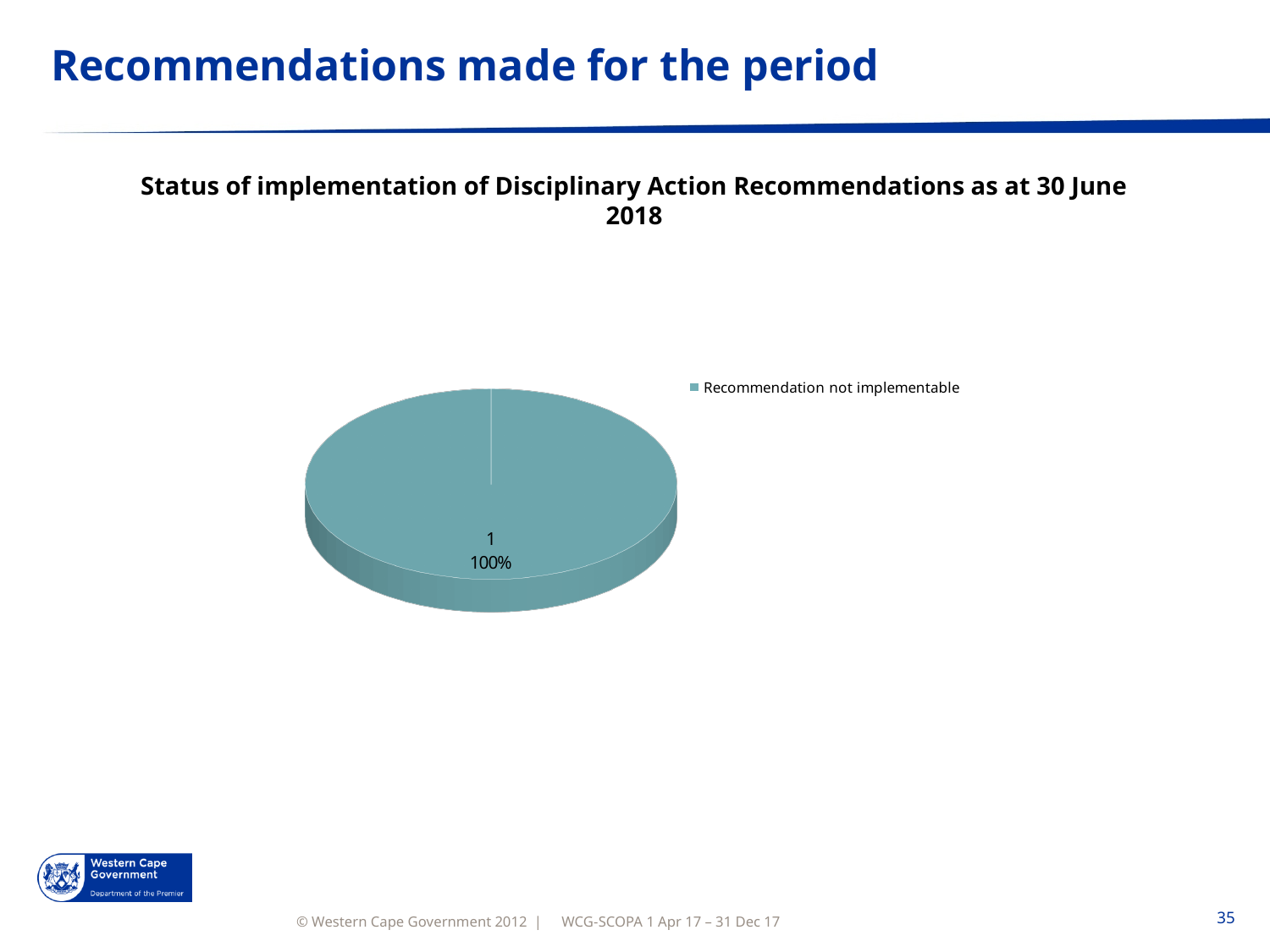
How many slices does the pie chart have? 1 Which category makes up the largest share of the pie? Recommendation not implementable What category label appears in the chart's legend? Recommendation not implementable What kind of chart is shown on the slide? pie chart What is the value shown for "Recommendation not implementable"? 1 What share of the pie does "Recommendation not implementable" represent? 100% How many entries does the legend list? 1 What is the title of the chart? Status of implementation of Disciplinary Action Recommendations as at 30 June 2018